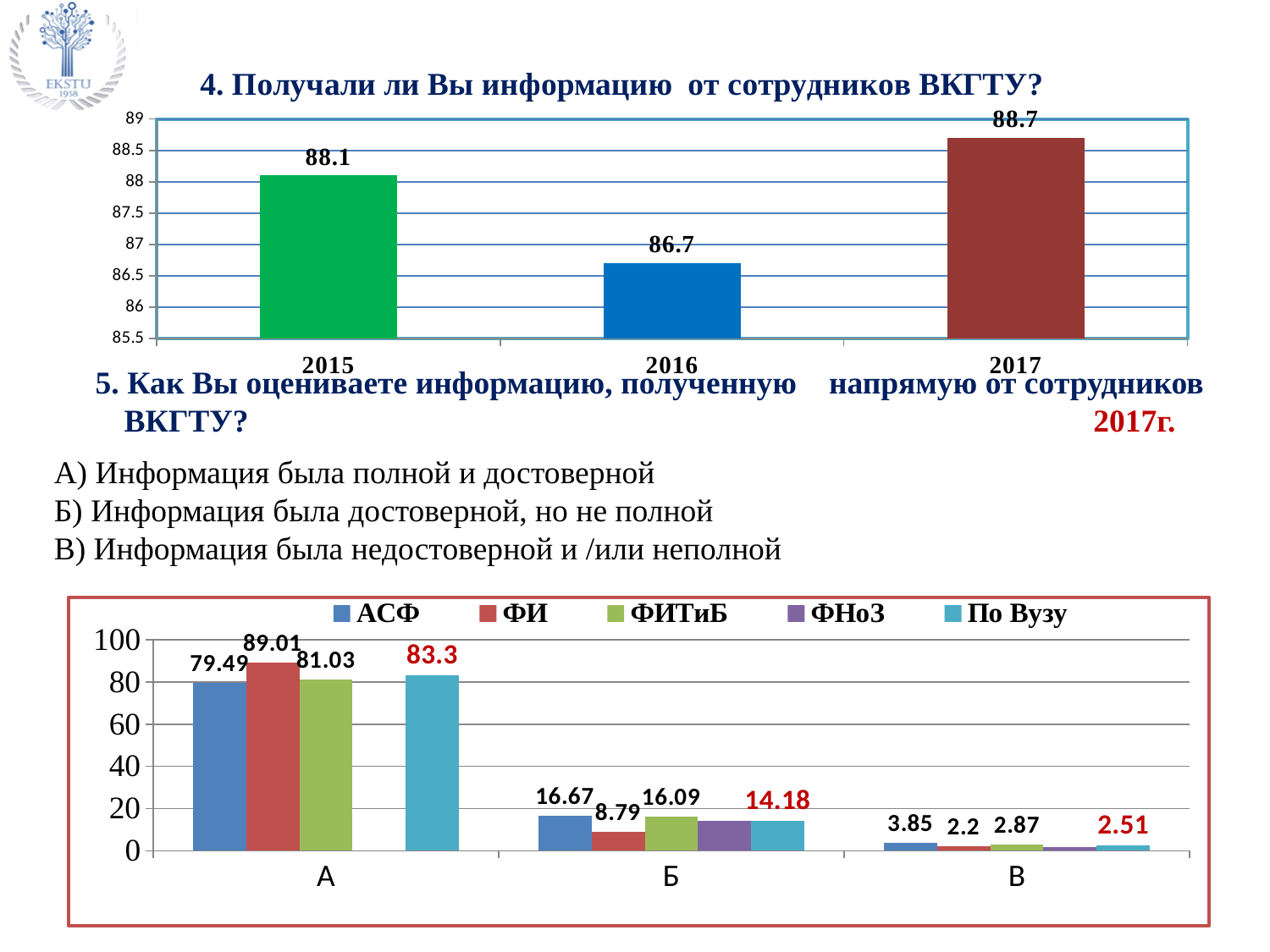
What kind of chart is the top chart? bar chart In the top chart, how many years are shown on the x axis? 3 In the top chart, which year has the lowest value? 2016 In the top chart, what is the difference between the values for 2017 and 2016? 2.0 In the bottom chart, how many series does the legend list? 5 In the bottom chart, what is the difference between АСФ and ФИТиБ in category В? 0.98 In the bottom chart, what is the value for ФИ in category А? 89.01 In the top chart, which year has the highest value? 2017 In the bottom chart, which series has the highest value in category А? ФИ In the top chart, what is the value for 2015? 88.1 In the bottom chart, what is the value for По Вузу in category Б? 14.18 In the bottom chart, which is larger in category Б: АСФ or ФИ? АСФ